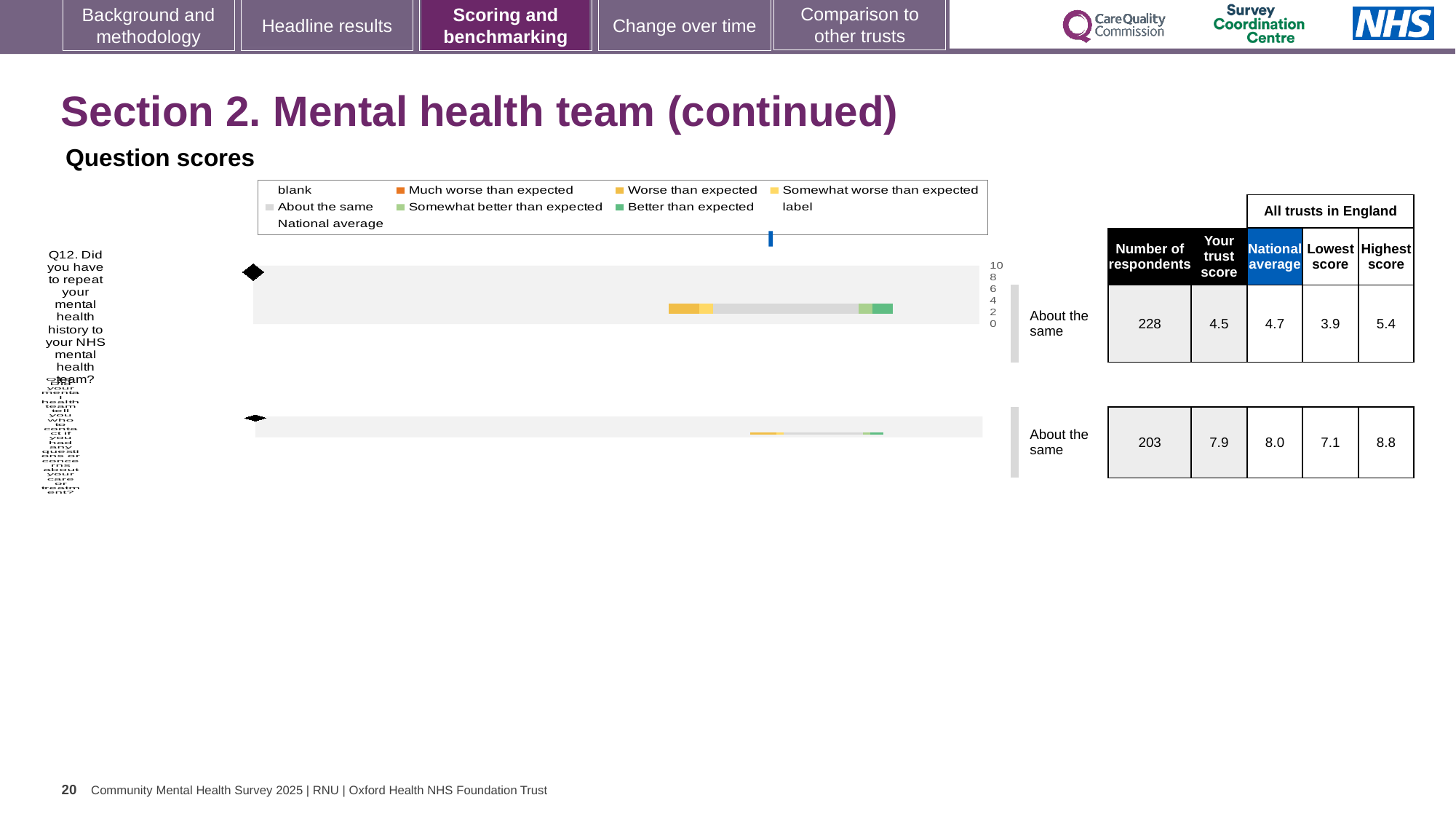
What benchmark category is shown for Q12? About the same For the second question row, what is the difference between the national average and the trust score? 0.1 How many respondents answered the second question row on the slide? 203 What is the highest score among all trusts in England for Q12? 5.4 What is the lowest score among all trusts in England for Q12? 3.9 How many respondents answered Q12? 228 What is the trust score for the second question row on the slide? 7.9 What is the national average score for Q12? 4.7 What is the trust score for Q12 (Did you have to repeat your mental health history to your NHS mental health team?)? 4.5 For Q12, what is the difference between the highest score and the lowest score among all trusts in England? 1.5 What kind of chart is used to show the question scores? Bar chart For Q12, which is larger: the trust score or the national average? National average